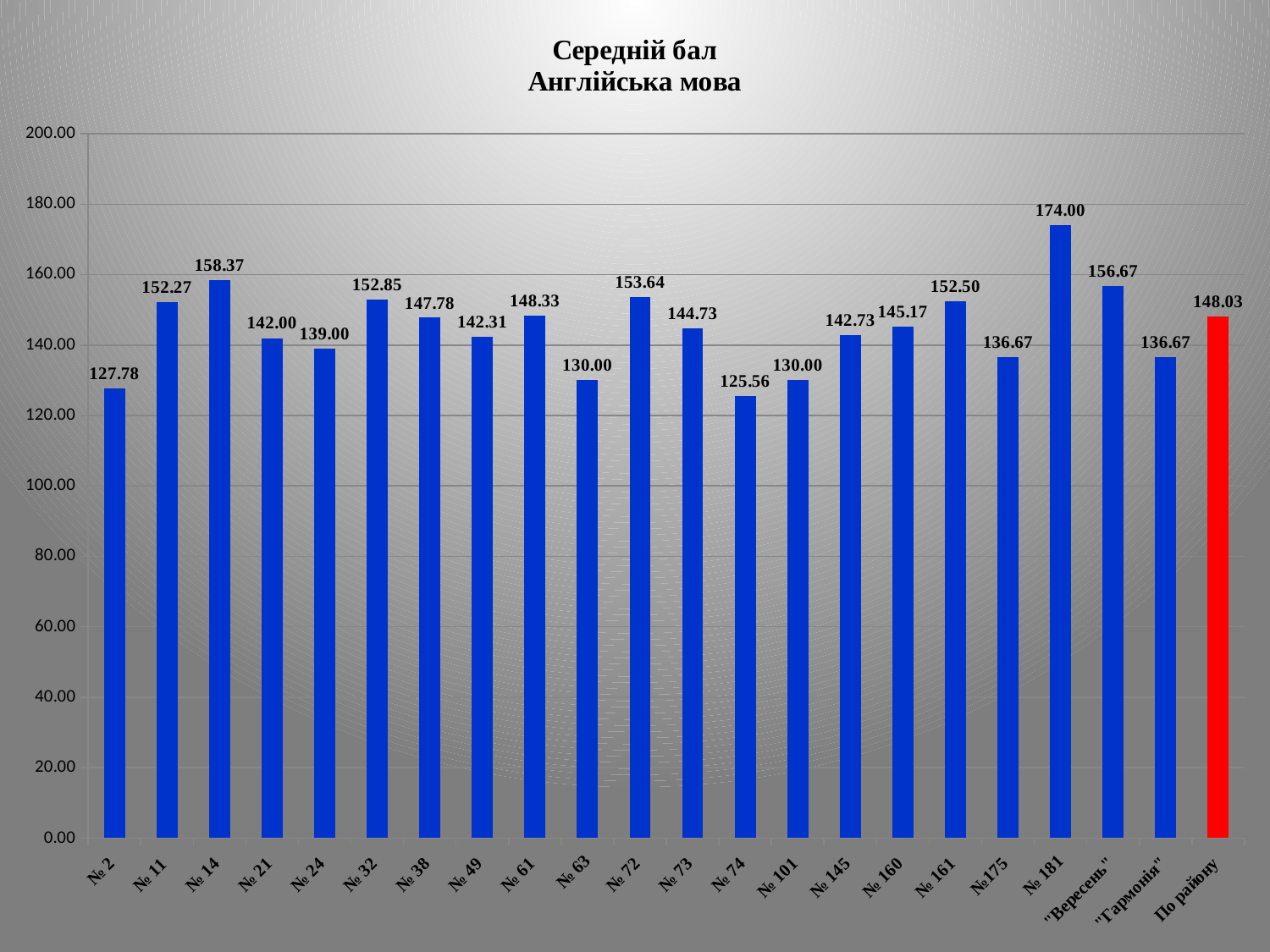
What is the difference between the values for № 181 and № 74? 48.44 Which category has the lowest value? № 74 Which has a larger value, № 72 or № 73? № 72 What is the value for По району? 148.03 What kind of chart is shown on the slide? bar chart Is the value for № 2 greater or less than 140.00? less Which category has the highest value? № 181 Which category's bar is coloured red? По району How many categories are shown on the x axis? 22 What is the value for "Вересень"? 156.67 What is the value for № 181? 174.00 What is the difference between the values for "Вересень" and "Гармонія"? 20.00